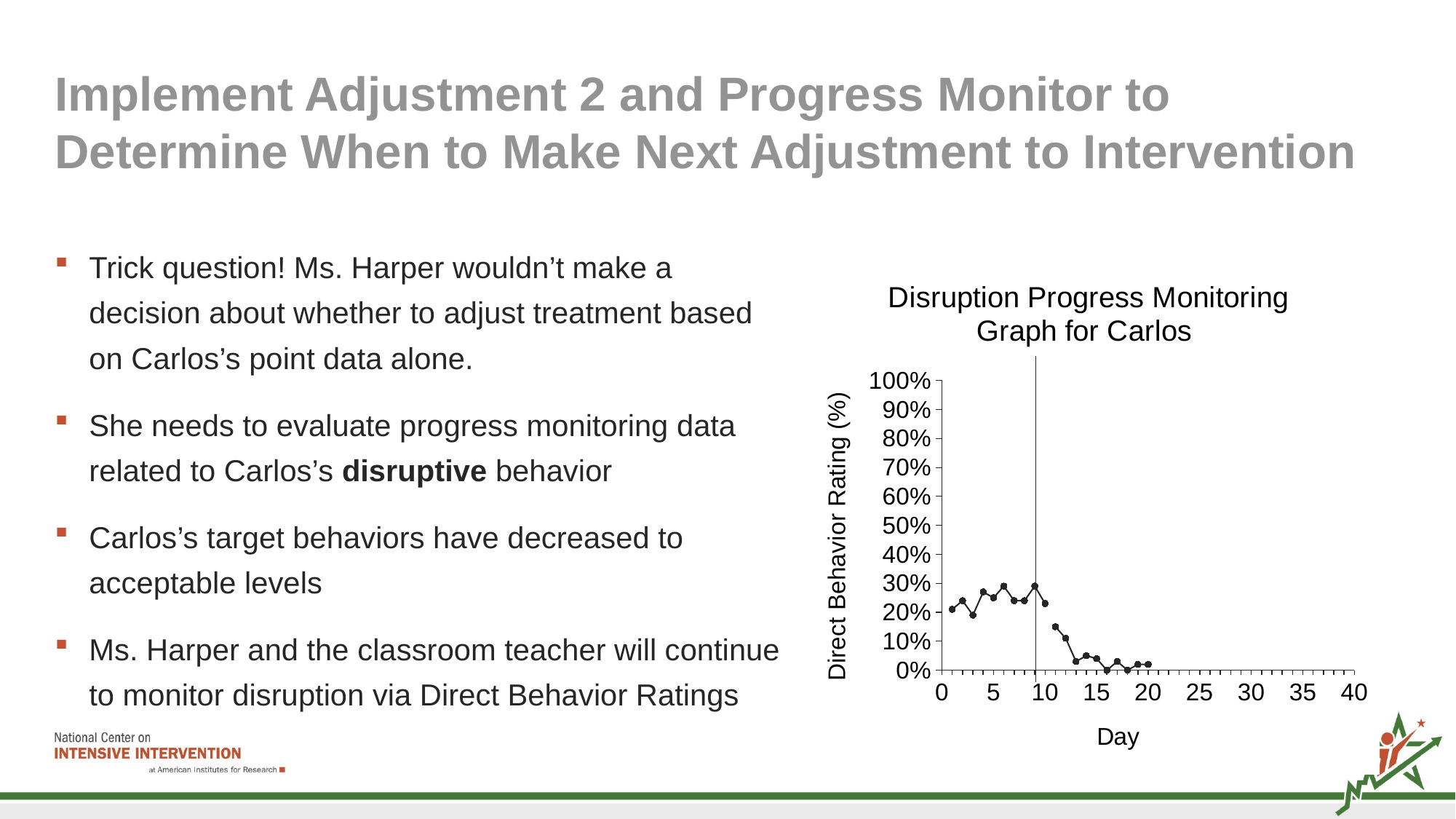
Is the value for Day 13 greater or less than 10%? less What is the label of the vertical axis of the chart? Direct Behavior Rating (%) What is the title of the chart? Disruption Progress Monitoring Graph for Carlos Which has the larger value, Day 4 or Day 14? Day 4 Is the value for Day 6 greater or less than 20%? greater How many data points are plotted in the chart? 20 What is the highest value shown on the horizontal (Day) axis? 40 Do the values in the chart generally rise or fall as the day number increases? fall Is the value for Day 11 greater or less than 10%? greater Which has the larger value, Day 18 or Day 9? Day 9 What kind of chart is shown on the slide? line chart